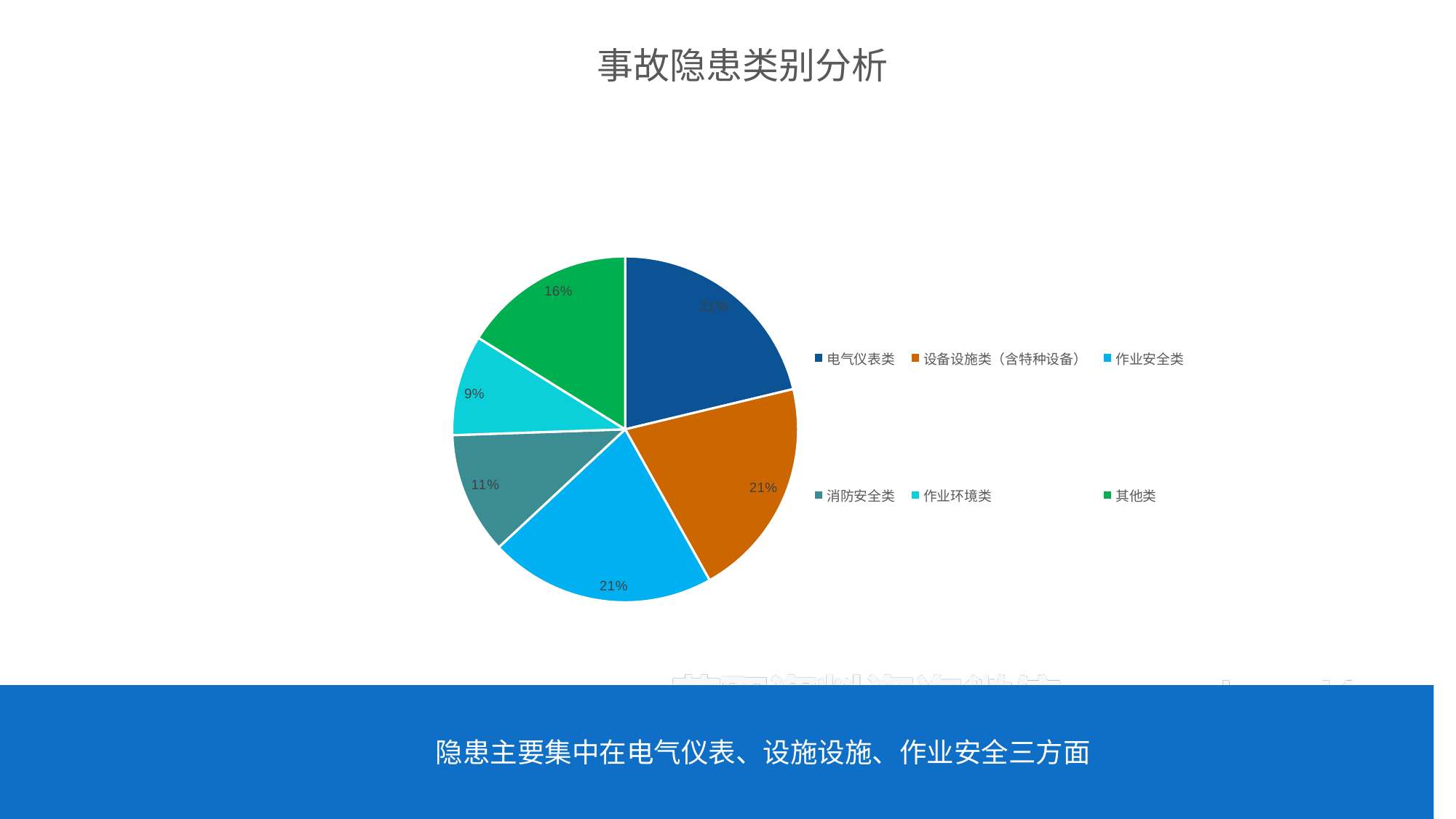
What percentage is shown for 电气仪表类? 21% What share of the pie does 其他类 account for? 16% Which category has the smallest slice of the pie? 作业环境类 What percentage is shown for 设备设施类（含特种设备）? 21% How many categories are shown in the pie chart? 6 What kind of chart is shown on the slide? Pie chart What is the title of the chart? 事故隐患类别分析 What is the value shown for 作业环境类? 9% What is the difference between the shares of 其他类 and 作业环境类? 7% Which is larger, the share of 消防安全类 or the share of 作业环境类? 消防安全类 What is the value shown for 消防安全类? 11% What is the difference between the shares of 作业安全类 and 消防安全类? 10%